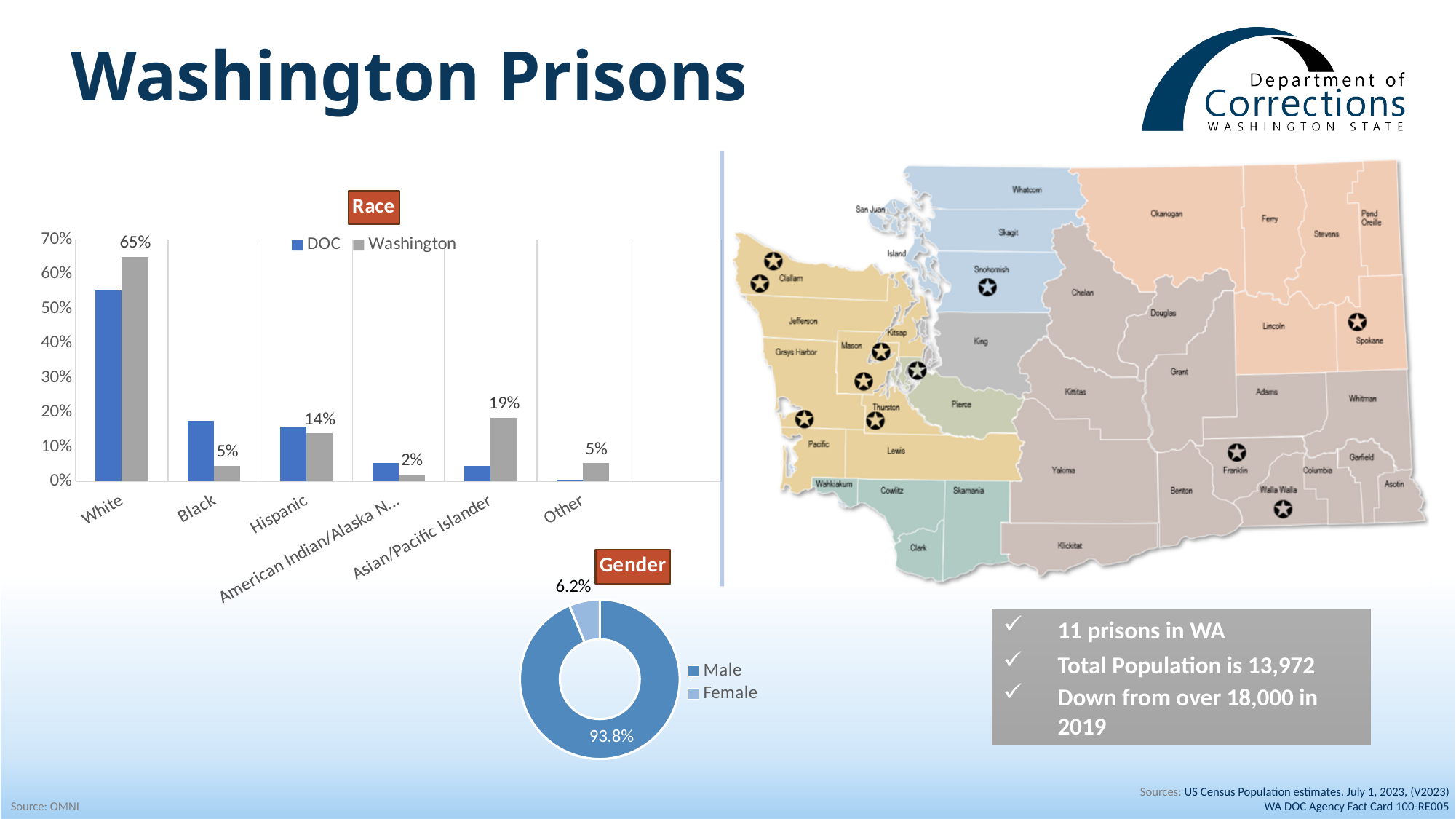
What kind of chart is the Race chart? bar chart On the Race chart, is the DOC value for Black greater or less than 10%? greater On the Gender chart, what share is Male? 93.8% On the Race chart, is the DOC value for White greater or less than 50%? greater On the Race chart, for Black, which series has the larger value, DOC or Washington? DOC On the Race chart, which category has the highest Washington value? White On the Race chart, which category has the lowest Washington value? American Indian/Alaska N... On the Race chart, what is the Washington value for White? 65% On the Race chart, what is the difference between the Washington values for White and Asian/Pacific Islander? 46% On the Race chart, what is the Washington value for Asian/Pacific Islander? 19% On the Race chart, what is the Washington value for Hispanic? 14% On the Race chart, how many series does the legend list? 2